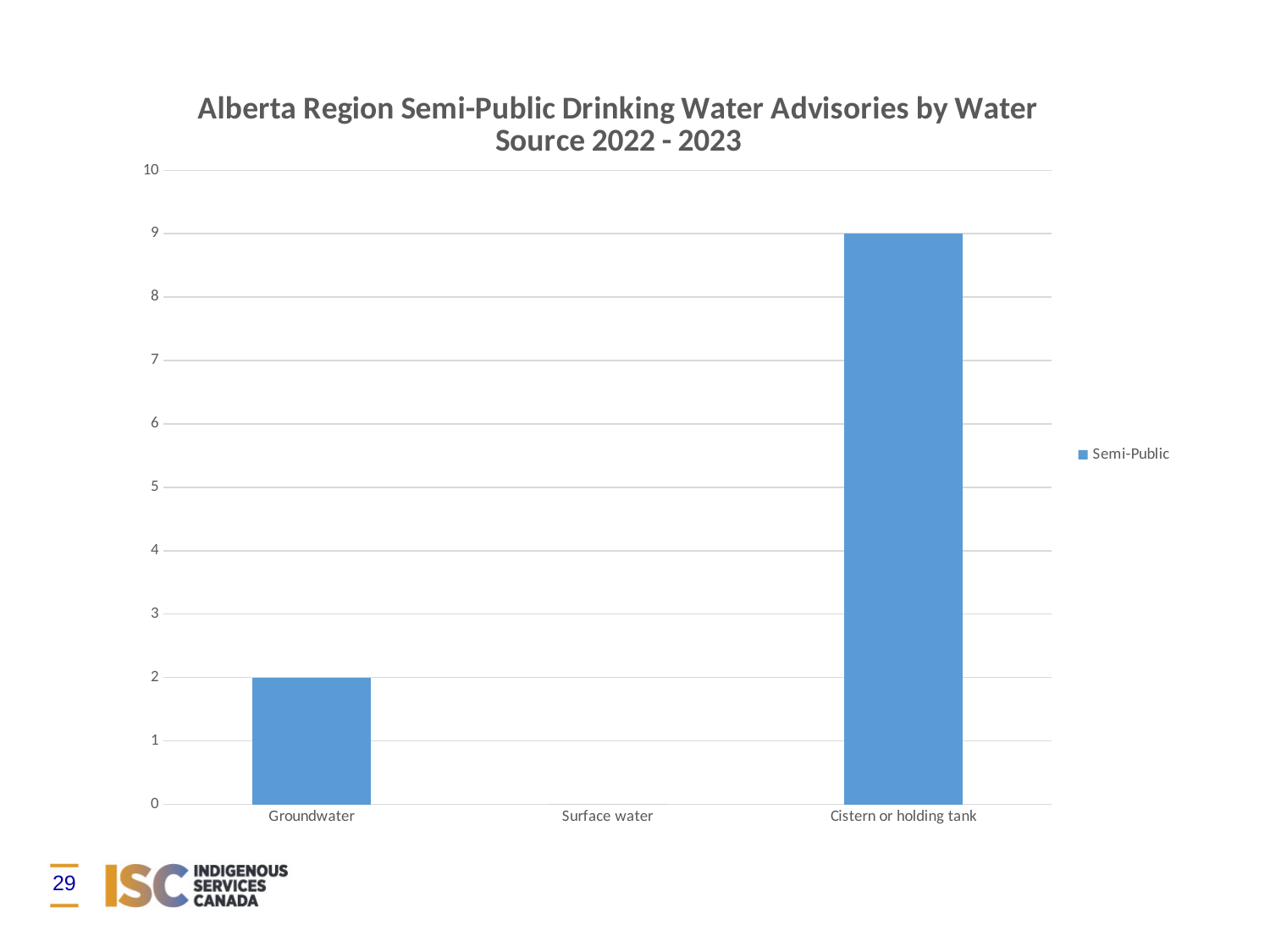
Which is larger, the value for Groundwater or the value for Cistern or holding tank? Cistern or holding tank How many water source categories are shown on the x axis? 3 How many series does the legend list? 1 What kind of chart is shown on the slide? Bar chart What is the value for Cistern or holding tank? 9 Which water source has the lowest number of advisories? Surface water What is the value for Surface water? 0 What is the name of the series listed in the legend? Semi-Public What is the value for Groundwater? 2 What is the difference between the values for Cistern or holding tank and Groundwater? 7 Which water source has the highest number of advisories? Cistern or holding tank Is the value for Cistern or holding tank greater or less than 5? greater